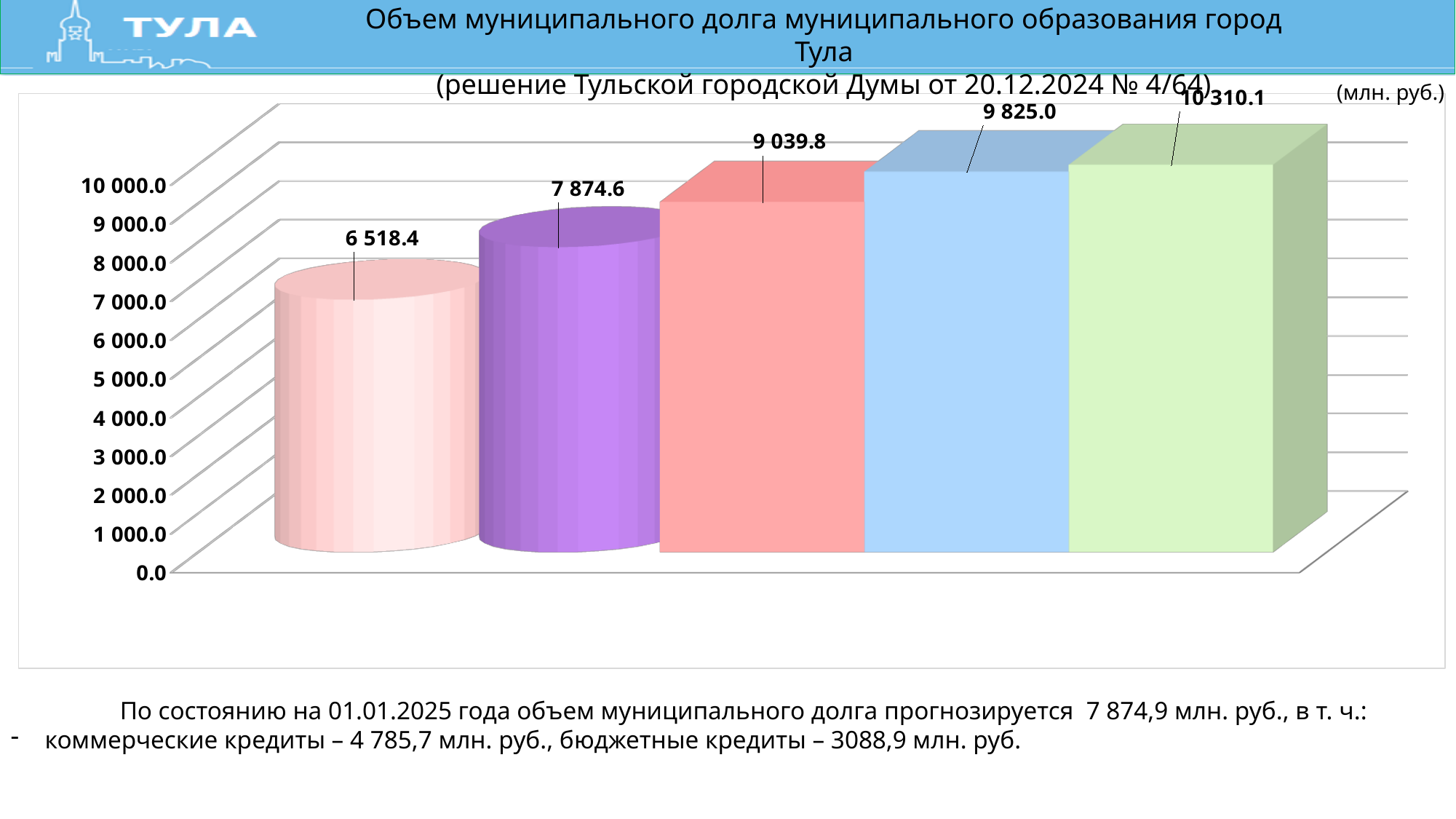
How many bars are plotted in the chart? 5 What is the difference between the value of the last bar (10 310.1) and the first bar (6 518.4)? 3 791.7 Which bar has the highest value? the last (green) bar, 10 310.1 What is the value shown on the first (leftmost, pink) bar? 6 518.4 What is the value shown on the fourth (blue) bar? 9 825.0 What is the value shown on the third (red) bar? 9 039.8 Do the values rise or fall from left to right across the chart? rise In what units are the chart values given, according to the label at the top right of the chart? млн. руб. What is the value shown on the last (rightmost, green) bar? 10 310.1 What is the value shown on the second (purple) bar? 7 874.6 Which bar has the lowest value? the first (pink) bar, 6 518.4 What kind of chart is shown on the slide? bar chart